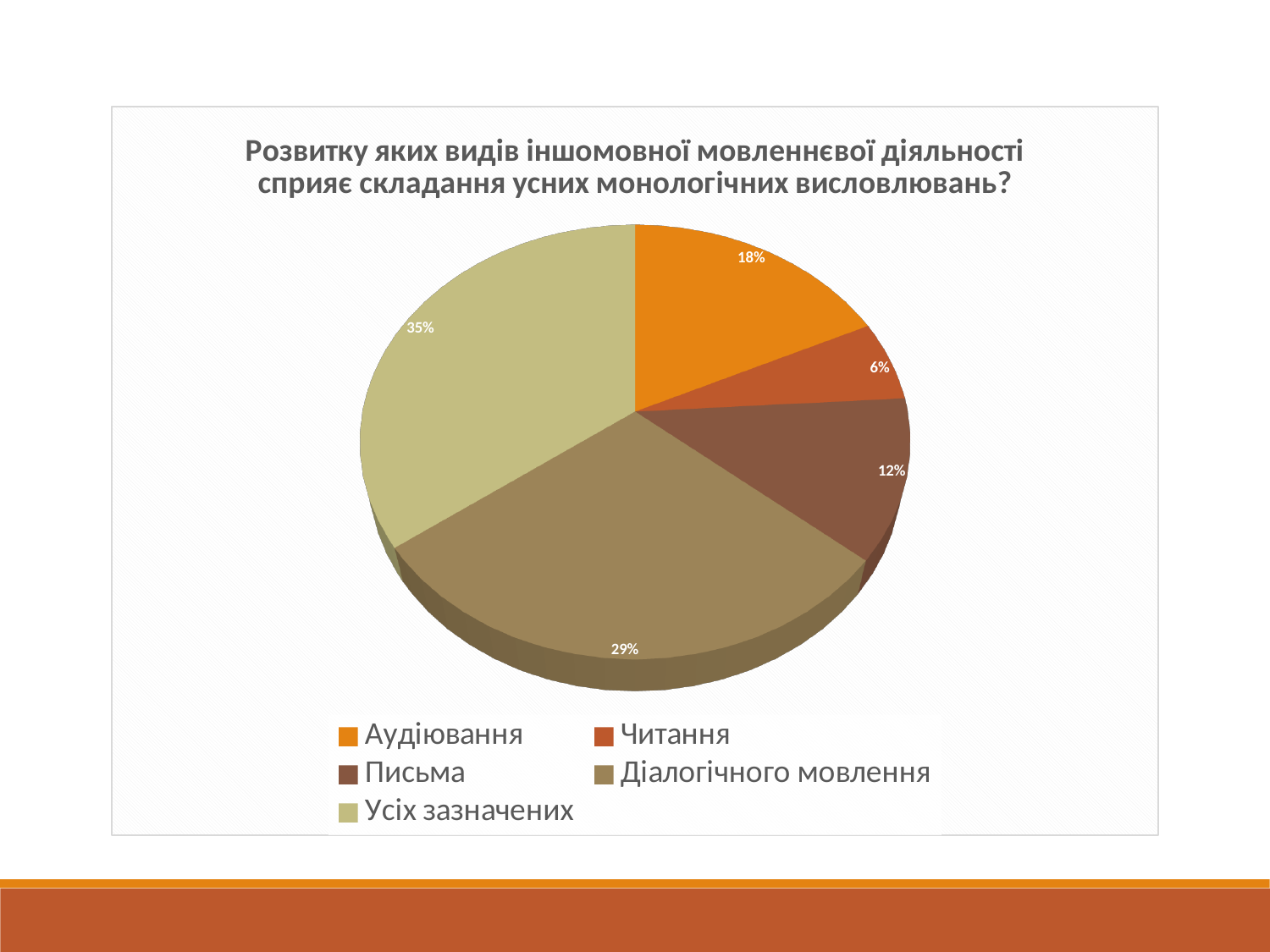
What percentage is shown for Діалогічного мовлення? 29% Which category has the smallest share of the pie? Читання What is the difference in percentage points between Усіх зазначених and Діалогічного мовлення? 6 Which category is shown in orange in the legend? Аудіювання What kind of chart is shown on the slide? pie chart What percentage is shown for Читання? 6% What percentage is shown for Аудіювання? 18% What percentage is shown for Письма? 12% How many categories does the legend list? 5 Which is larger, the share for Аудіювання or the share for Письма? Аудіювання What percentage is shown for Усіх зазначених? 35% Which category has the largest share of the pie? Усіх зазначених